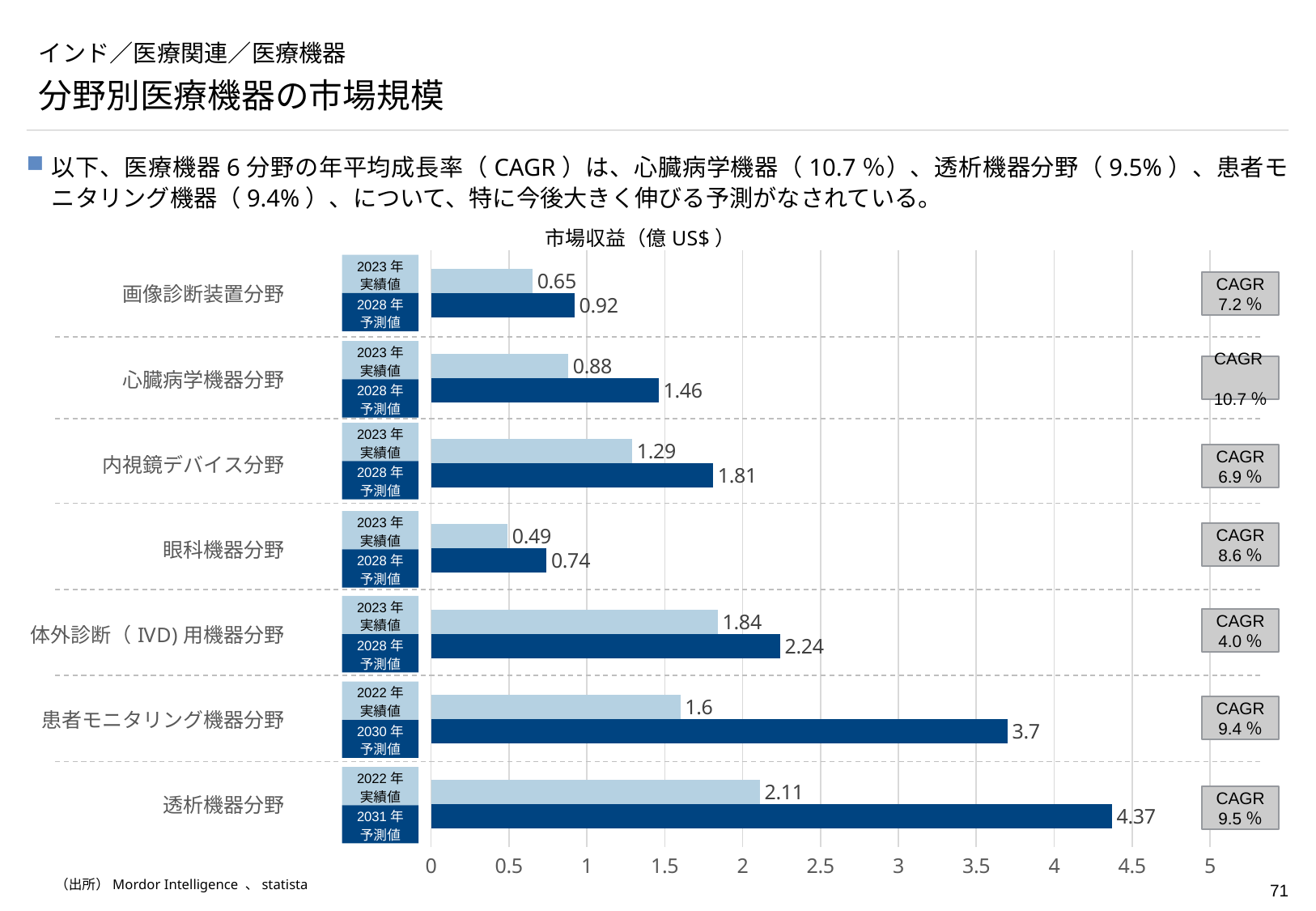
画像診断装置分野の2028年予測値はいくらですか？ 0.92 2023年実績値が最も小さい分野はどれですか？ 眼科機器分野 心臓病学機器分野の2028年予測値と2023年実績値の差はいくらですか？ 0.58 透析機器分野の2022年実績値はいくらですか？ 2.11 これはどの種類のグラフですか？ 棒グラフ 内視鏡デバイス分野の2023年実績値と体外診断（IVD）用機器分野の2023年実績値では、どちらが大きいですか？ 体外診断（IVD）用機器分野 透析機器分野の2031年予測値は4より大きいですか、小さいですか？ 大きい 眼科機器分野のCAGRはいくらですか？ 8.6% このグラフには分野がいくつ示されていますか？ 7 グラフの横軸の単位は何ですか？ 億US$ 予測値が最も大きい分野はどれですか？ 透析機器分野 患者モニタリング機器分野の2030年予測値はいくらですか？ 3.7